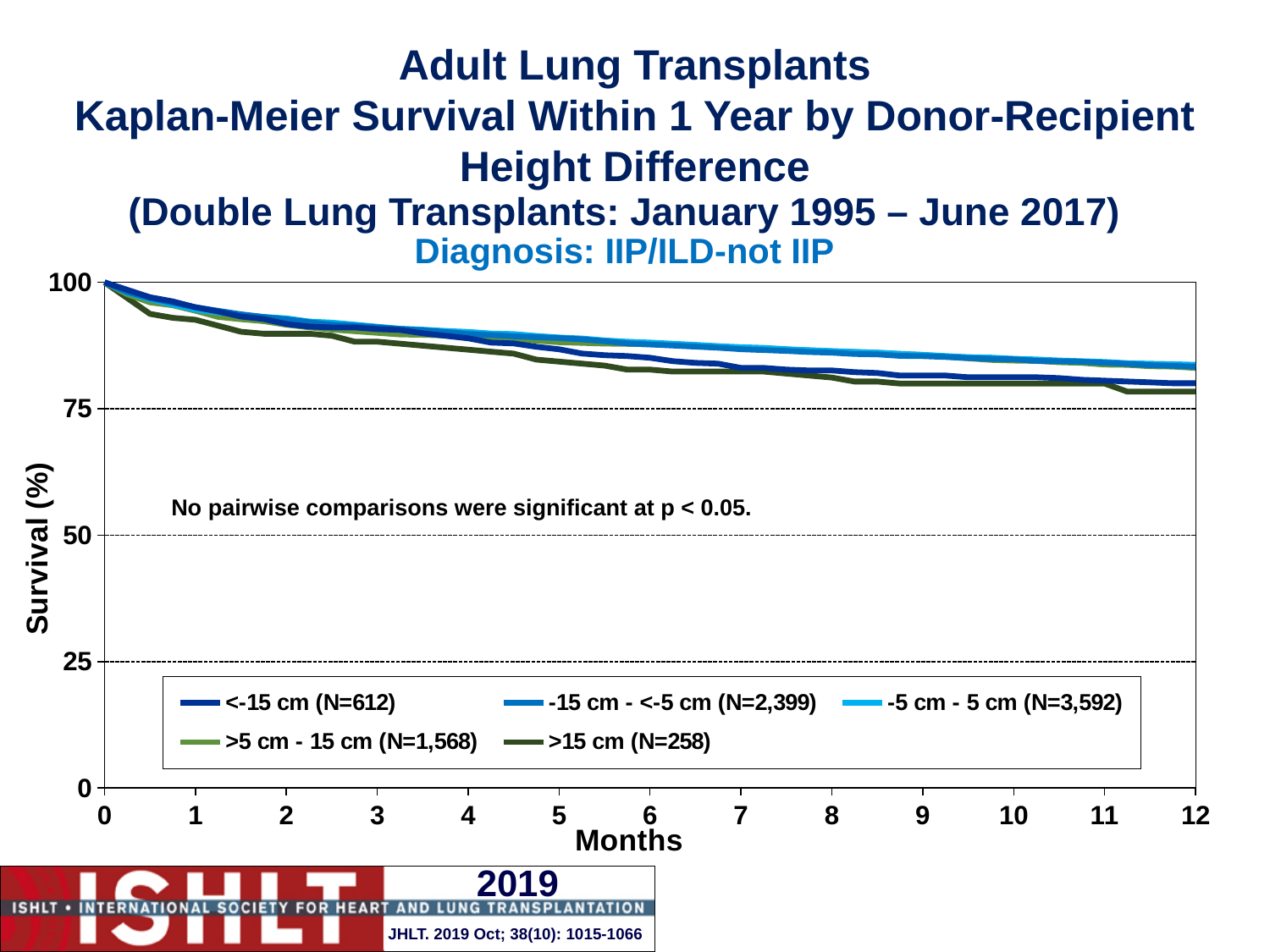
Do the survival curves rise or fall as months increase? Fall What does the annotation inside the chart say about pairwise comparisons? No pairwise comparisons were significant at p < 0.05. Is the survival value for the <-15 cm group at 6 months greater or less than 75? greater What is the N for the >15 cm group shown in the legend? 258 How many series does the legend list? 5 At 12 months, which group has higher survival: <-15 cm or >15 cm? <-15 cm Is the survival value for the >15 cm group at 12 months greater or less than 75? greater Which group has the lowest survival at 12 months? >15 cm How many tick marks are labelled on the Months axis? 13 Is the survival value for the -5 cm - 5 cm group at 12 months greater or less than 100? less What kind of chart is shown on the slide? Line chart